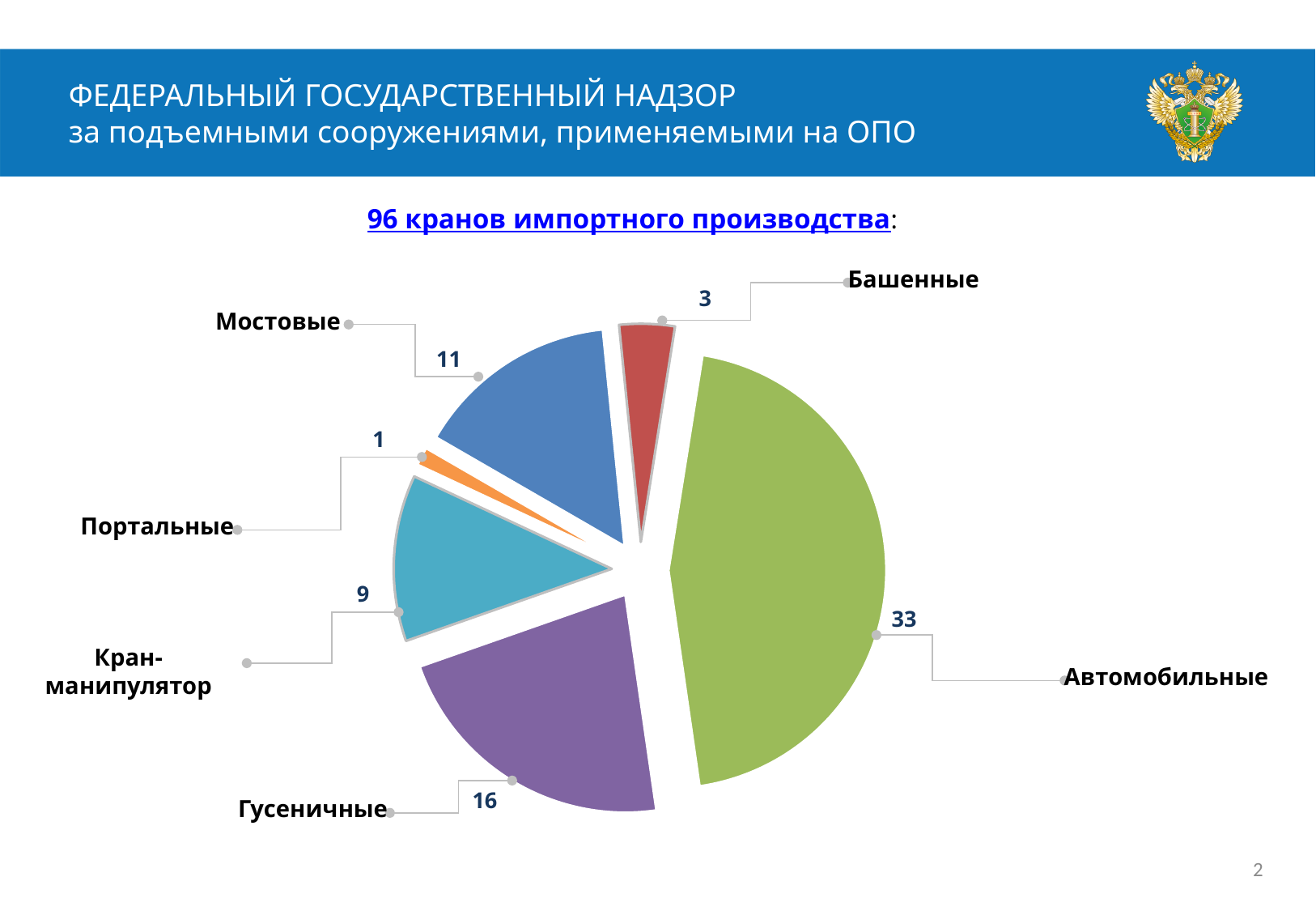
What is the title text above the pie chart? 96 кранов импортного производства: What is the difference between the values for Автомобильные and Гусеничные? 17 What kind of chart is shown on the slide? pie chart Which category has the smallest slice? Портальные What is the value for Автомобильные? 33 What is the value for Мостовые? 11 Which is larger, the value for Мостовые or the value for Кран-манипулятор? Мостовые What is the value for Кран-манипулятор? 9 What is the value for Башенные? 3 How many slices does the pie chart have? 6 What is the value for Гусеничные? 16 Which category has the largest slice? Автомобильные